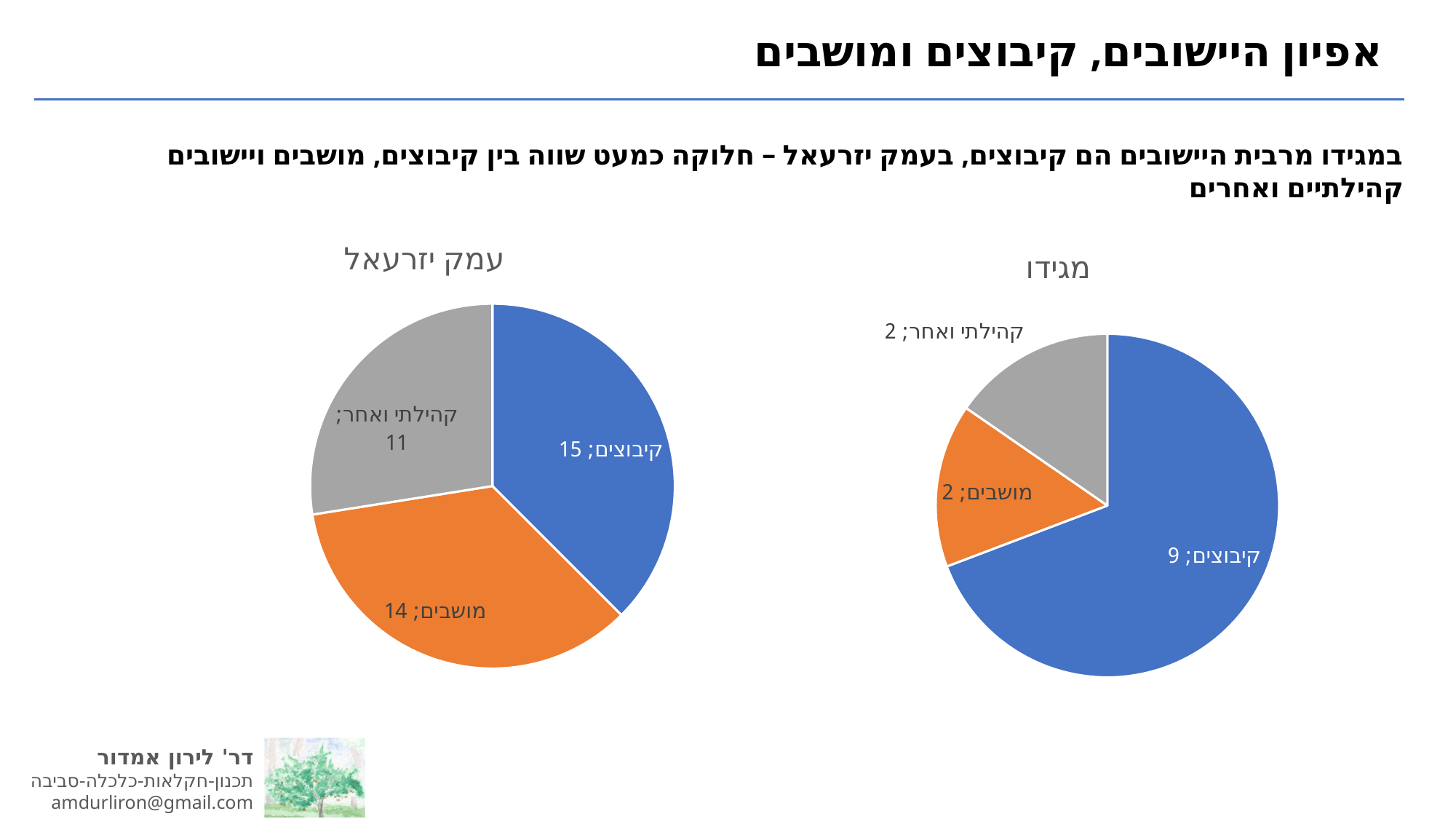
In the "מגידו" chart, what is the value for מושבים? 2 In the "עמק יזרעאל" chart, what is the value for מושבים? 14 What kind of chart is the "עמק יזרעאל" chart? pie chart In the "עמק יזרעאל" chart, what is the value for קהילתי ואחר? 11 In the "עמק יזרעאל" chart, what is the difference between the values for קיבוצים and קהילתי ואחר? 4 How many slices does the "מגידו" chart have? 3 In the "עמק יזרעאל" chart, which category has the smallest slice? קהילתי ואחר In the "עמק יזרעאל" chart, what is the value for קיבוצים? 15 In the "עמק יזרעאל" chart, what share of the total does מושבים represent? 35% In the "מגידו" chart, what is the value for קיבוצים? 9 In the "מגידו" chart, which category has the largest slice? קיבוצים In the "מגידו" chart, what is the difference between the values for קיבוצים and מושבים? 7